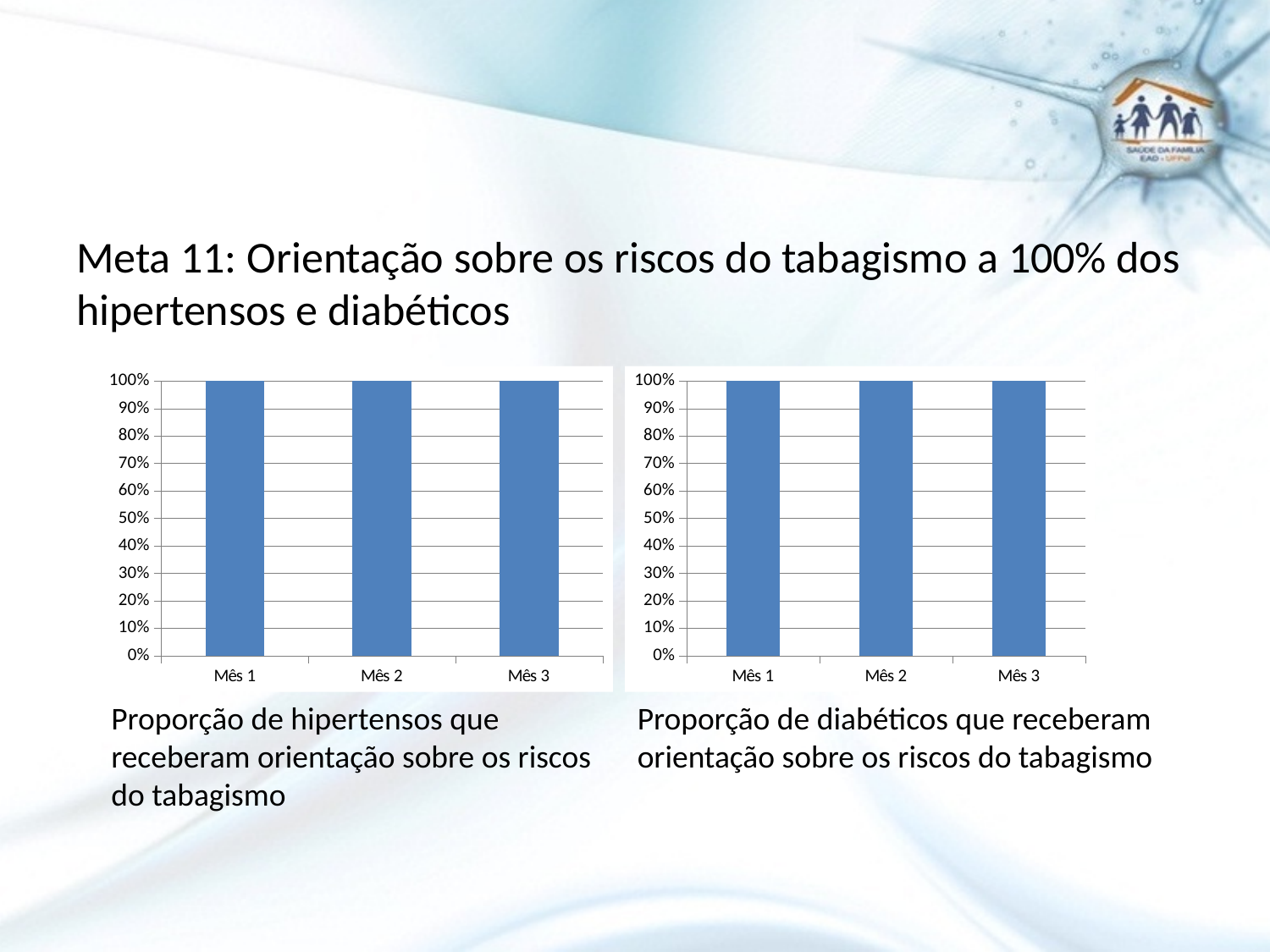
On the right chart, what is the value for Mês 1? 100% What kind of chart is the right chart? Bar chart How many bars does the right chart have? 3 How many charts are shown on the slide? 2 On the left chart, what is the value for Mês 2? 100% On the right chart (proportion of diabetic patients who received guidance on the risks of smoking), what is the value for Mês 3? 100% What kind of chart is the left chart? Bar chart How many categories are shown on the x axis of the left chart? 3 On the left chart, do the values rise, fall or stay the same from Mês 1 to Mês 3? Stay the same On the left chart (proportion of hypertensive patients who received guidance on the risks of smoking), what is the value for Mês 1? 100% On the right chart, is the value for Mês 2 greater or less than 50%? greater On the right chart, do the values rise, fall or stay the same from Mês 1 to Mês 3? Stay the same